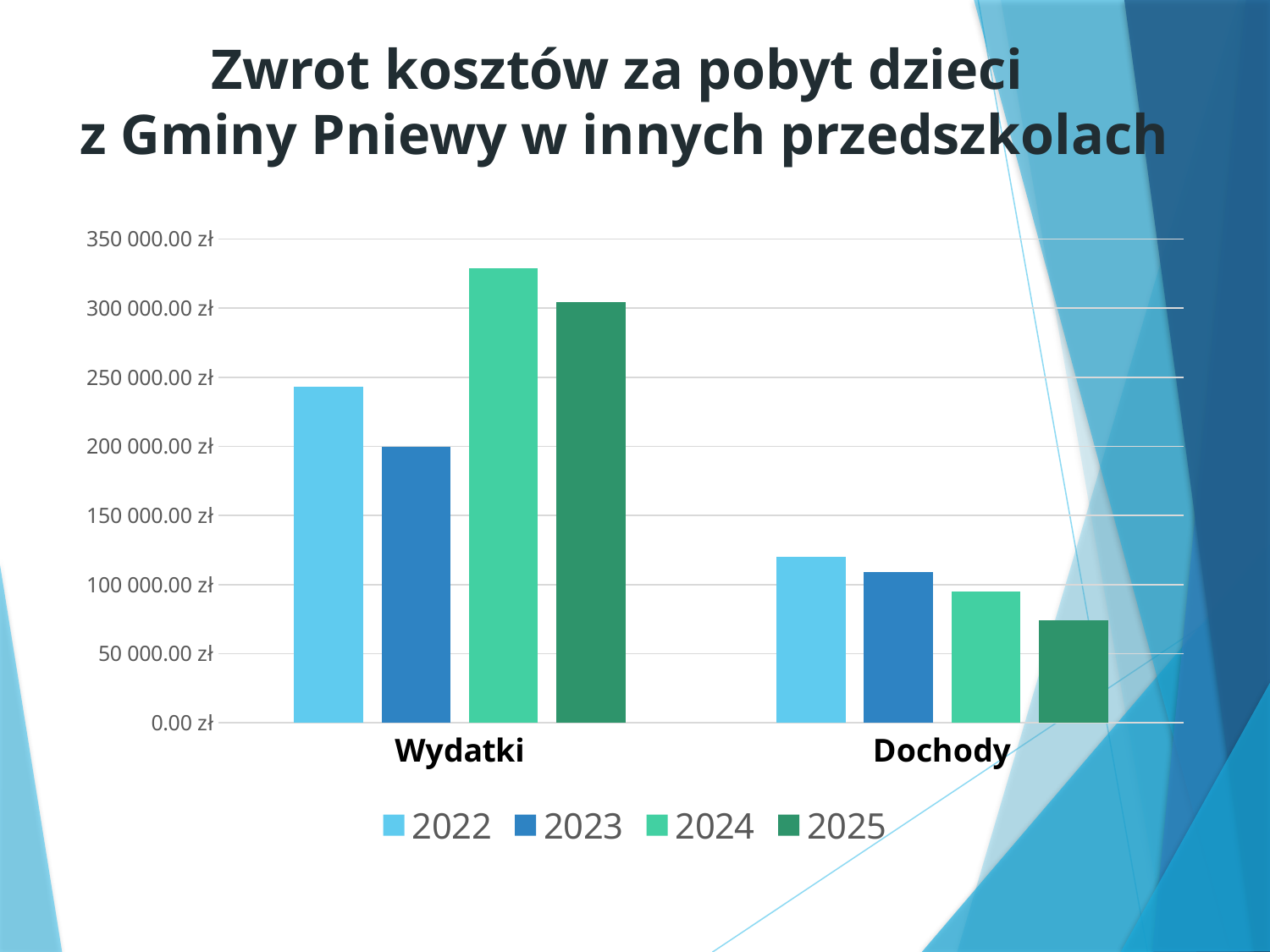
Which is larger: Wydatki in 2022 or Wydatki in 2025? Wydatki in 2025 Do the Dochody values rise or fall from 2022 to 2025? fall Which year has the lowest value for Dochody? 2025 Which year has the highest value for Wydatki? 2024 Which years are listed in the legend? 2022, 2023, 2024, 2025 Which year has the lowest value for Wydatki? 2023 Which year has the highest value for Dochody? 2022 What kind of chart is shown on the slide? bar chart Is the value for Dochody in 2025 greater or less than 100 000.00 zł? less How many series does the legend list? 4 Is the value for Wydatki in 2024 greater or less than 300 000.00 zł? greater How many categories are shown on the x axis? 2